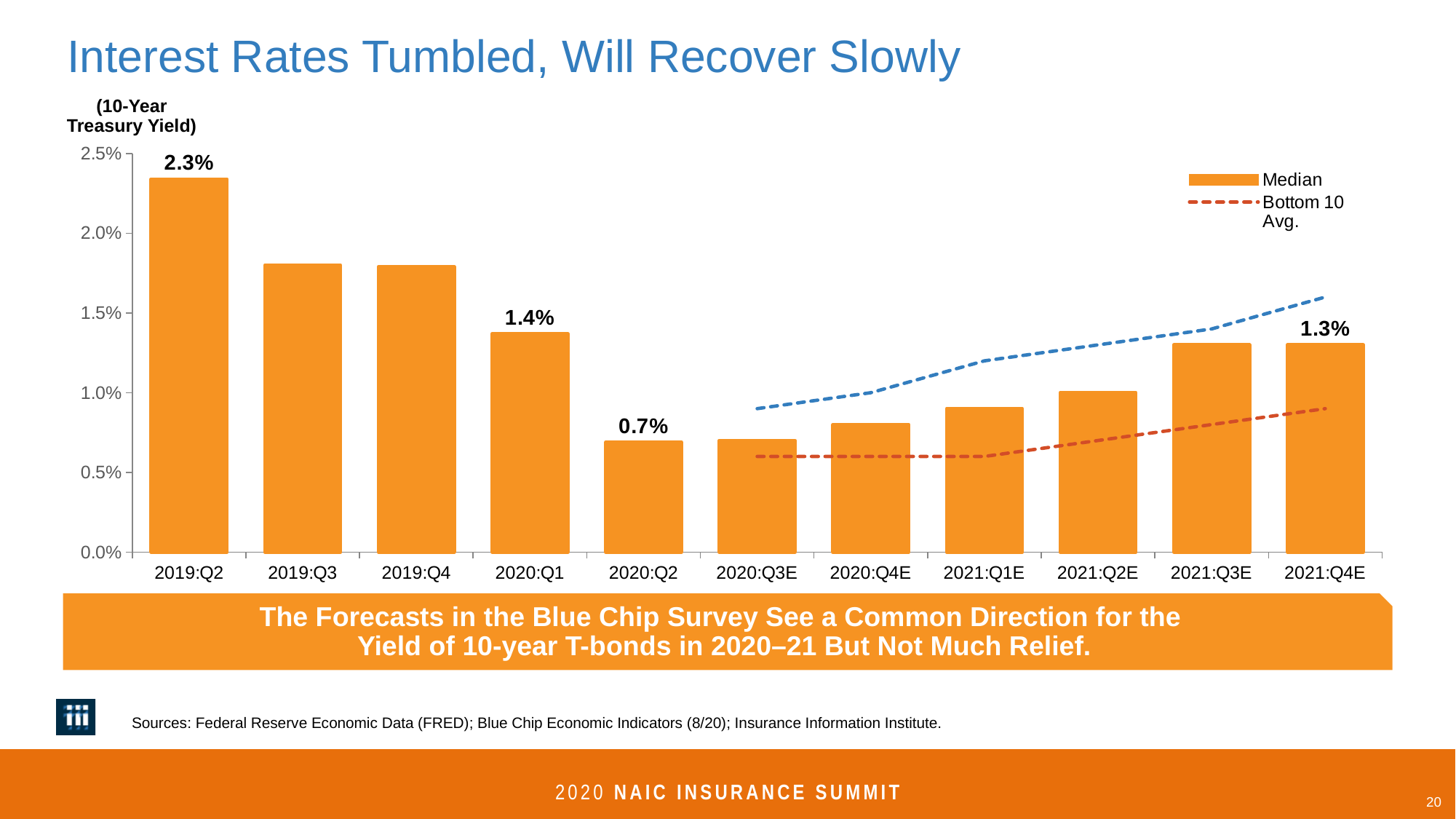
Is the median yield for 2019:Q3 greater or less than 1.5%? greater What is the median 10-year Treasury yield shown for 2020:Q1? 1.4% How many series does the chart's legend list? 2 Which quarter has the highest median 10-year Treasury yield in the chart? 2019:Q2 What is the difference between the median yield for 2020:Q1 and for 2020:Q2? 0.7% How many quarters are shown on the x axis of the chart? 11 What is the median 10-year Treasury yield shown for 2019:Q2? 2.3% What is the median 10-year Treasury yield forecast shown for 2021:Q4E? 1.3% Which is larger, the median yield for 2020:Q1 or for 2021:Q4E? 2020:Q1 What is the median 10-year Treasury yield shown for 2020:Q2? 0.7% Is the median yield for 2020:Q3E greater or less than 1.0%? less What is the difference between the median yield for 2019:Q2 and for 2020:Q1? 0.9%